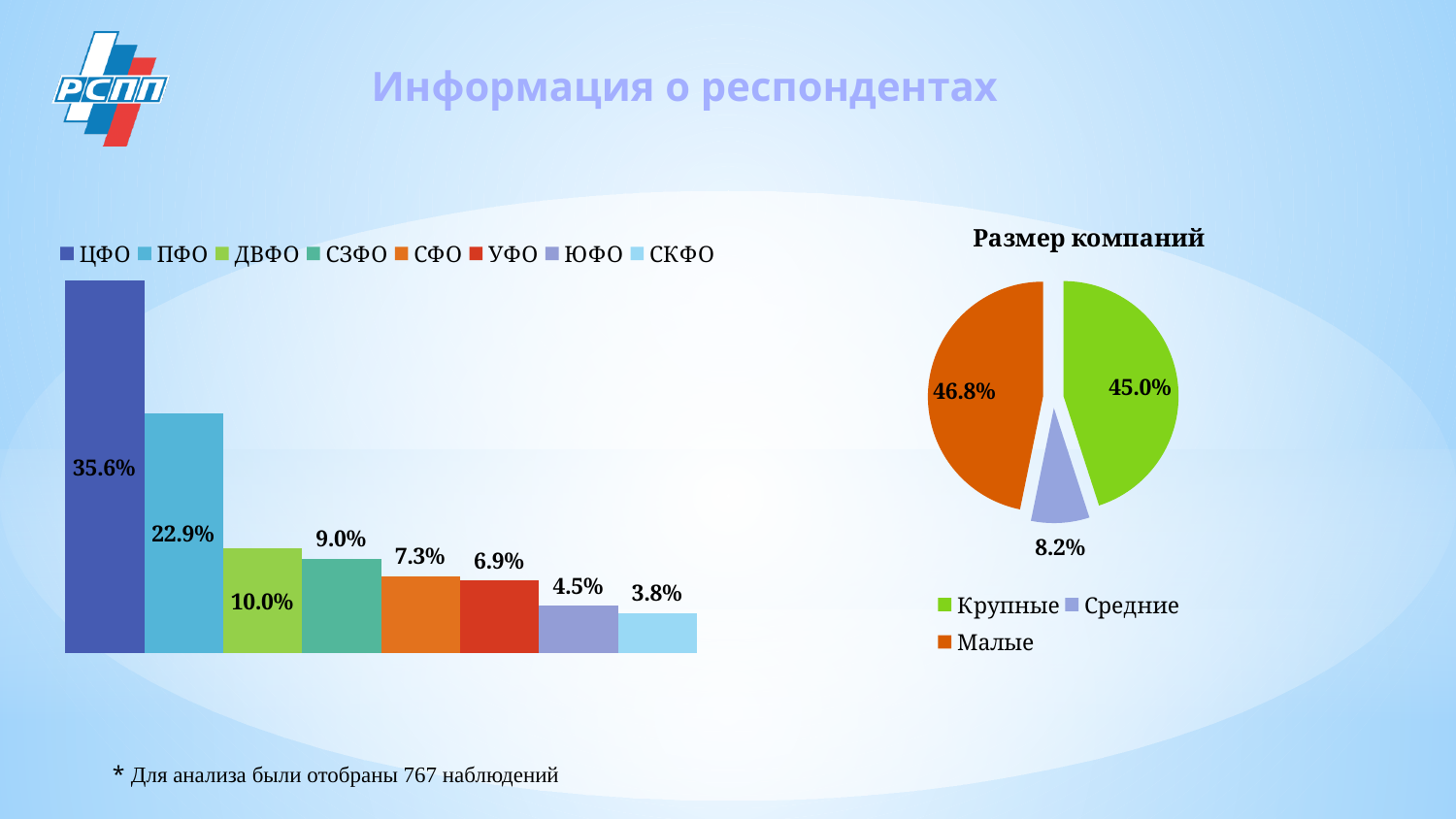
How many categories does the legend of the bar chart on the left list? 8 In the bar chart on the left, what is the value for ЦФО? 35.6% In the bar chart on the left, which category has the highest value? ЦФО In the chart titled 'Размер компаний', what is the difference between the shares of Малые and Крупные? 1.8% In the bar chart on the left, what is the value for СЗФО? 9.0% In the bar chart on the left, which category has the lowest value? СКФО In the chart titled 'Размер компаний', what share of the pie is Средние? 8.2% What kind of chart is the chart titled 'Размер компаний'? pie chart In the bar chart on the left, which is larger, the value for СФО or the value for УФО? СФО In the chart titled 'Размер компаний', which slice is the largest? Малые In the bar chart on the left, what is the difference between the values for ЦФО and ПФО? 12.7% What kind of chart is the chart on the left? bar chart